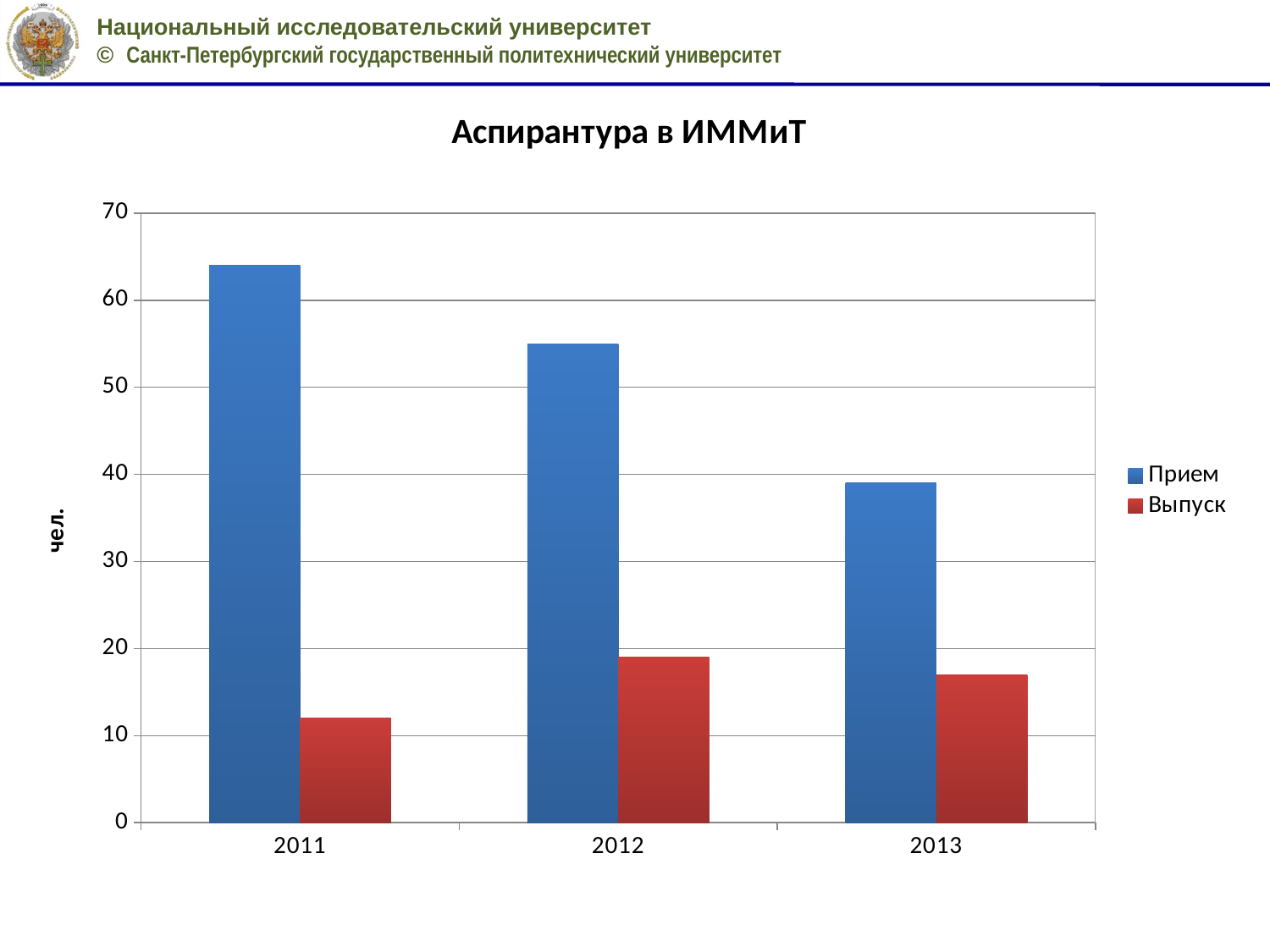
What kind of chart is shown on the slide? bar chart In which year is the value for Выпуск lowest? 2011 Is the value for Прием in 2012 greater or less than 50? greater Does the value for Прием rise or fall from 2011 to 2013? fall In which year is the value for Прием lowest? 2013 Which is larger in 2012, Прием or Выпуск? Прием In which year is the value for Прием highest? 2011 How many years are shown on the x axis? 3 What is the title of the chart? Аспирантура в ИММиТ How many series does the legend list? 2 Is the value for Выпуск in 2013 greater or less than 20? less Is the value for Прием in 2011 greater or less than 60? greater